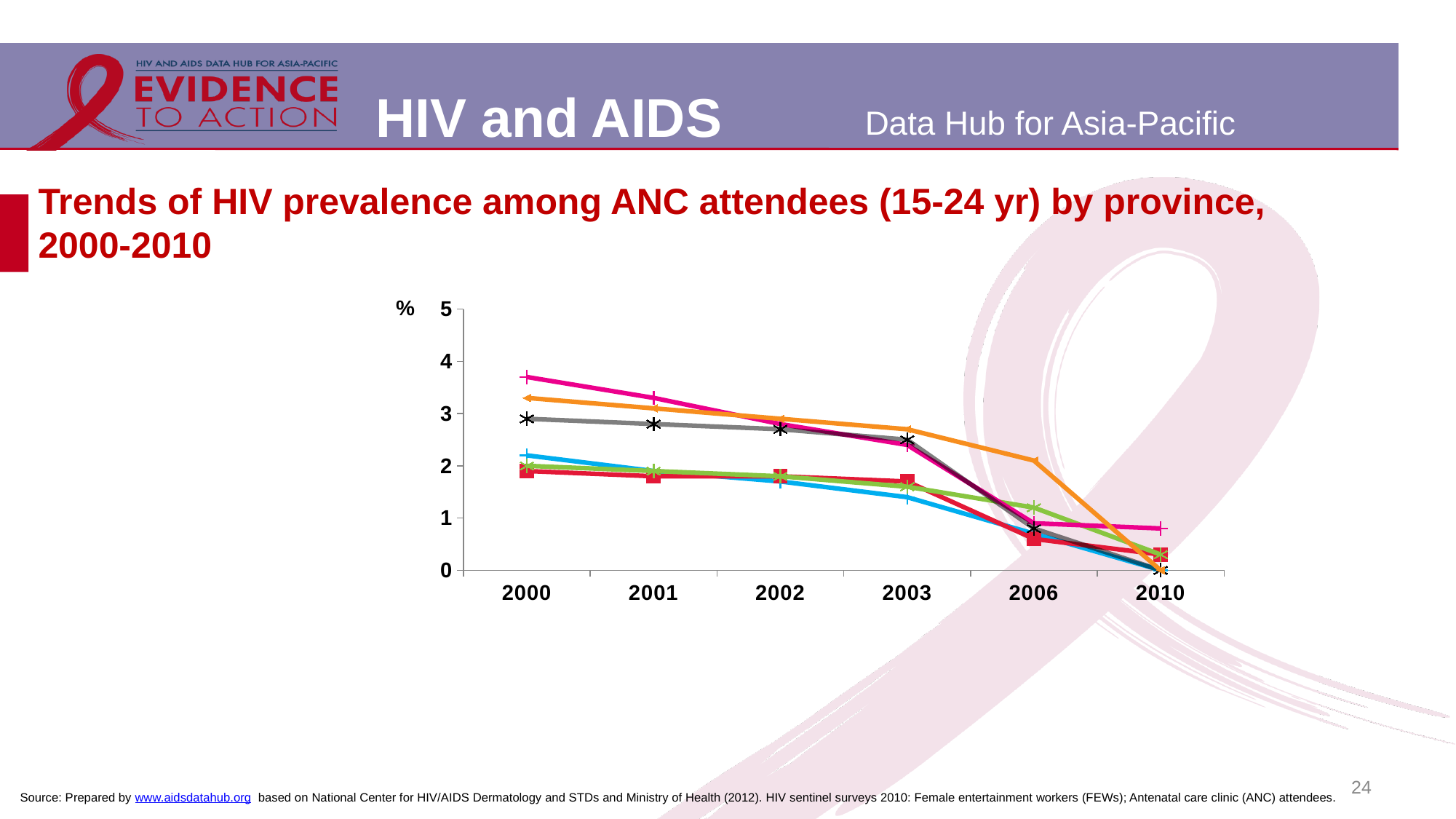
Which years are shown on the x axis of the chart? 2000, 2001, 2002, 2003, 2006, 2010 Is the value of the grey line in 2003 greater or less than 2? greater How many lines are plotted in the chart? 6 What kind of chart is shown on the slide? line chart Is the value of the pink line in 2000 greater or less than 3? greater Is the value of the orange line in 2003 greater or less than 2? greater How many years are marked on the x axis of the chart? 6 Do the lines in the chart generally rise or fall from 2000 to 2010? fall Which line has the highest value in 2000? the pink line What is the highest value marked on the y axis of the chart? 5